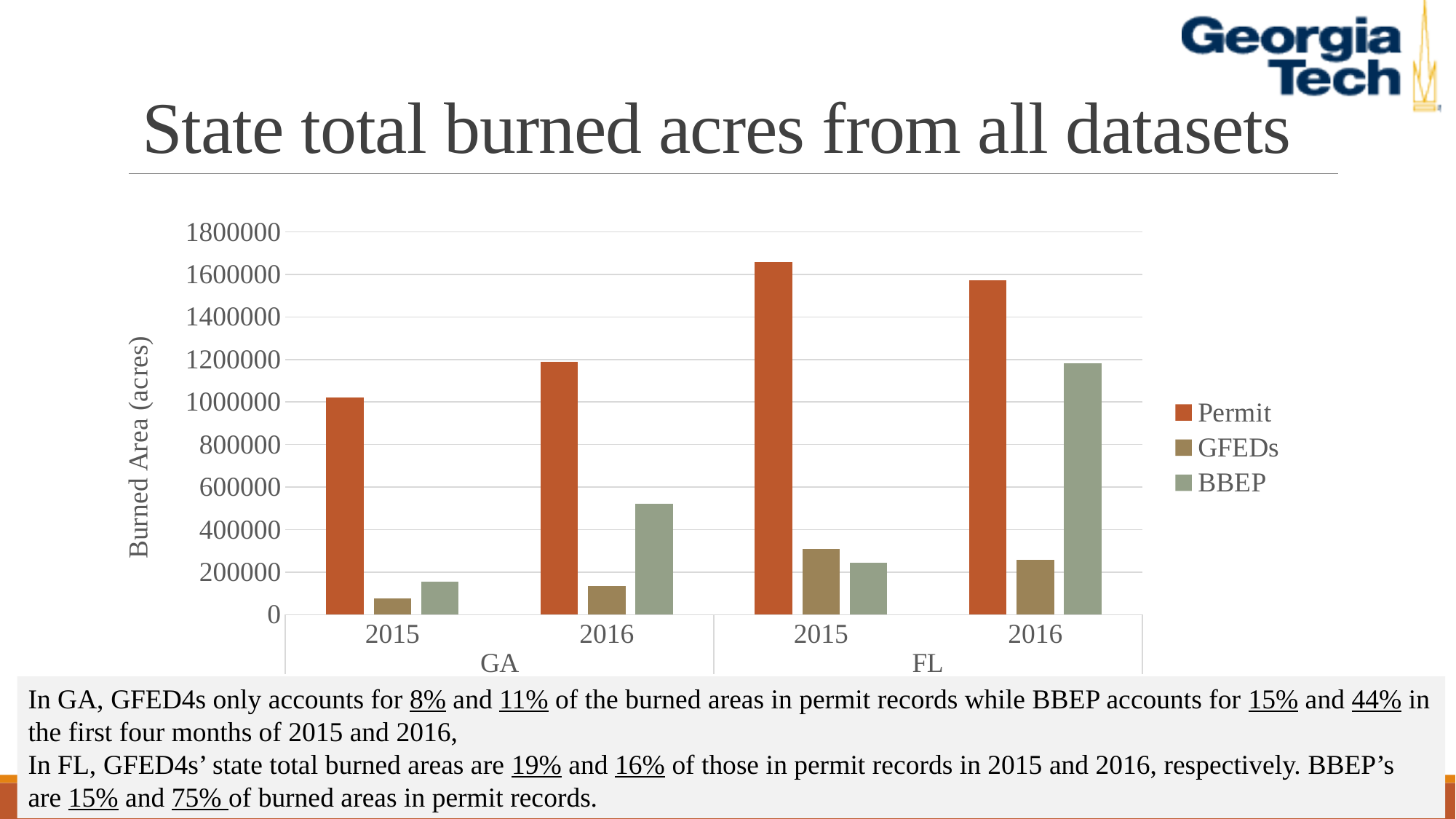
In FL 2015, which is larger, the GFEDs bar or the BBEP bar? GFEDs What is the label on the y axis? Burned Area (acres) Which state-year group has the highest Permit bar? FL 2015 Is the Permit value for GA 2015 greater or less than 800000? greater Which state-year group has the lowest GFEDs bar? GA 2015 Which is larger, the Permit bar for GA 2016 or the Permit bar for FL 2016? FL 2016 Is the BBEP value for GA 2016 greater or less than 400000? greater How many state-year groups are plotted along the x axis? 4 How many series does the legend list? 3 What kind of chart is shown on the slide? bar chart Which state-year group has the highest BBEP bar? FL 2016 Is the GFEDs value for GA 2015 greater or less than 200000? less